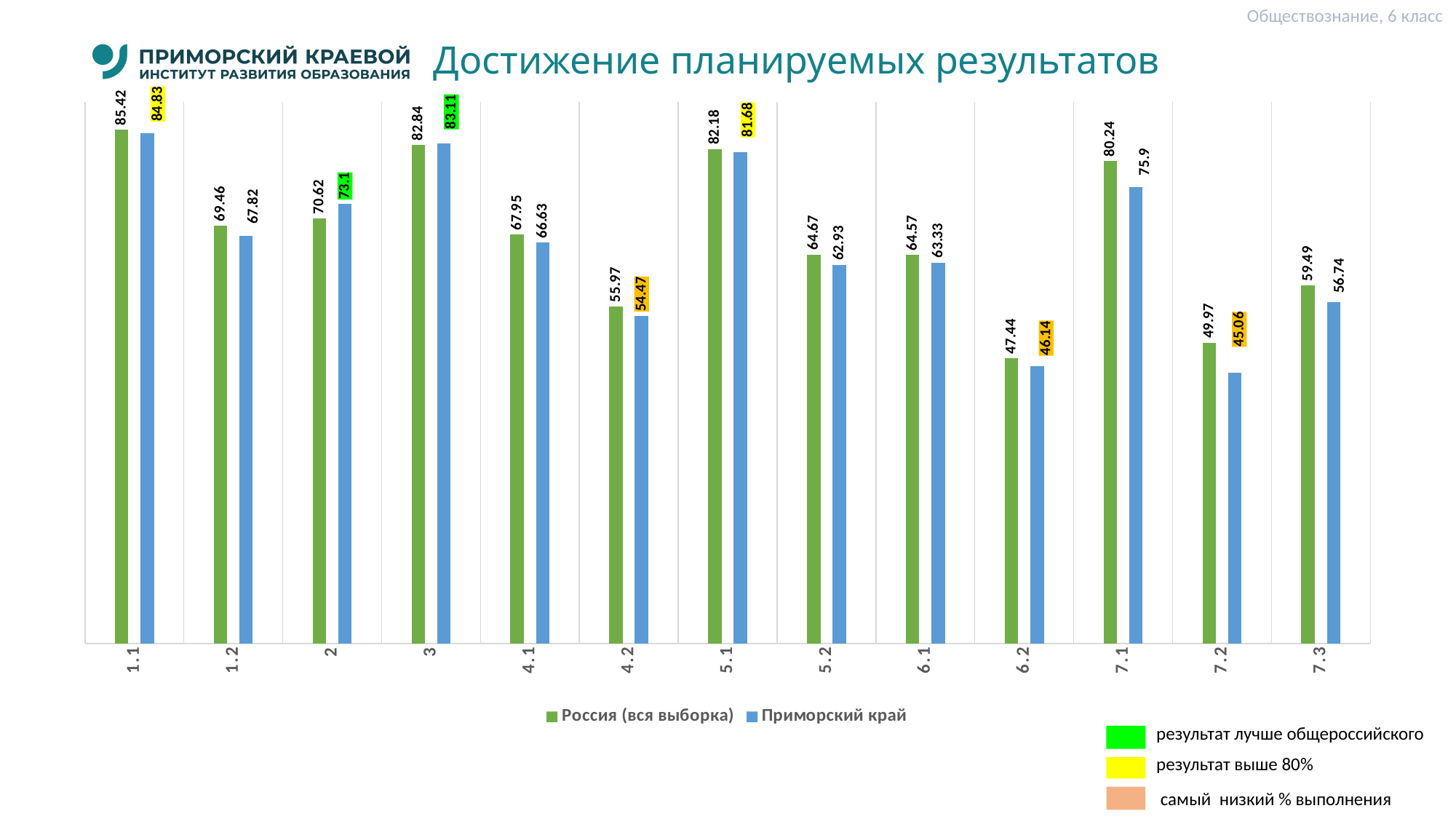
Which category has the lowest value for Приморский край? 7.2 For category 2, which series has the larger value: Россия (вся выборка) or Приморский край? Приморский край What kind of chart is shown on the slide? Bar chart Which category has the lowest value for Россия (вся выборка)? 6.2 Which category has the highest value for Приморский край? 1.1 How many series does the legend list? 2 What is the value for Россия (вся выборка) for category 4.2? 55.97 What is the value for Приморский край for category 7.1? 75.9 What is the title of the chart? Достижение планируемых результатов How many categories are shown on the x axis? 13 What is the difference between Россия (вся выборка) and Приморский край for category 7.1? 4.34 What is the difference between Россия (вся выборка) and Приморский край for category 7.2? 4.91